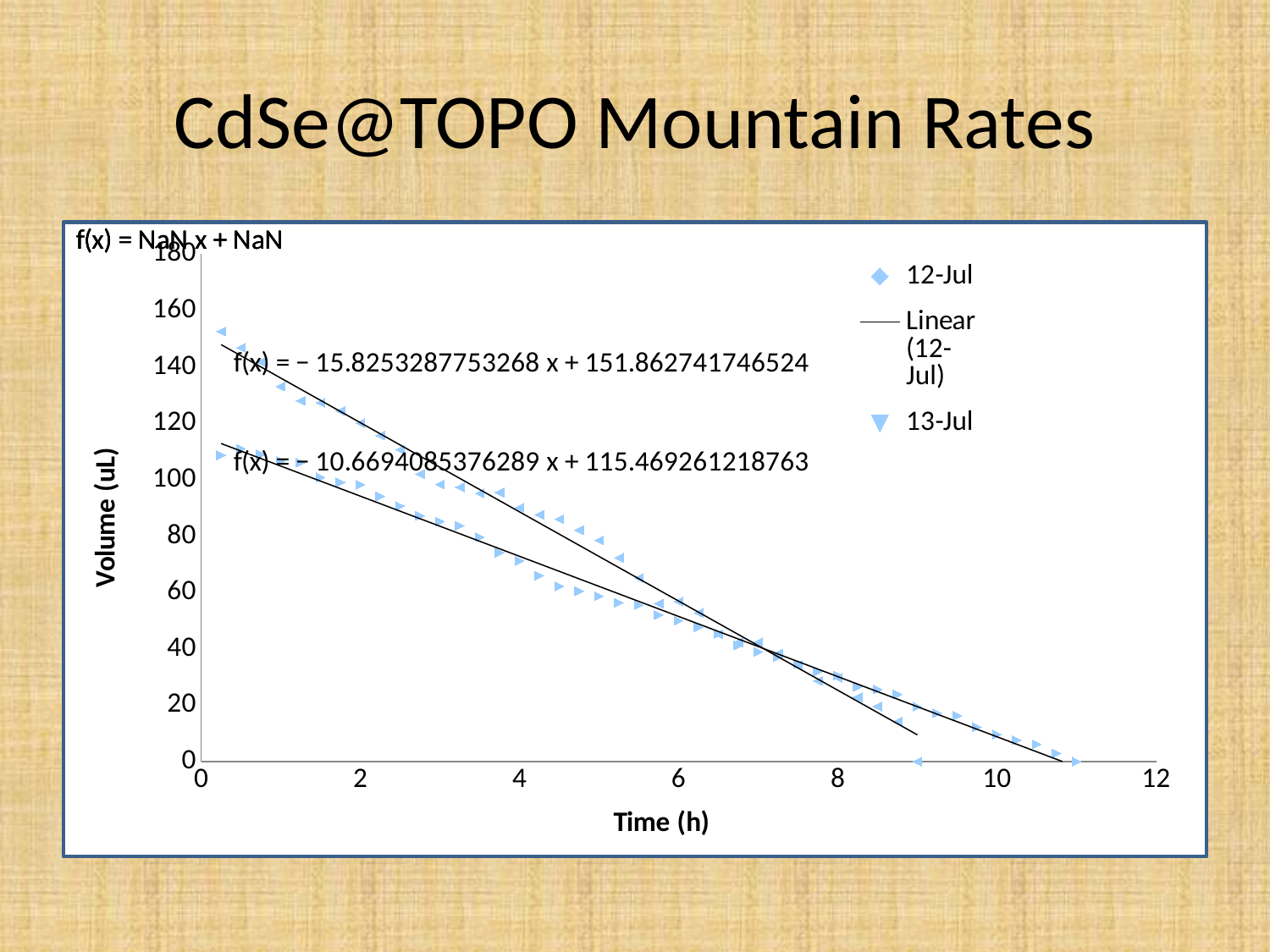
What is the intercept in the trendline equation printed lower on the chart? 115.469261218763 What kind of chart is shown on the slide? scatter chart Do the plotted volume values rise or fall as time increases? fall Which series reaches a volume of 0 at a later time: the one that starts near 150 or the one that starts near 110? the one that starts near 110 Is the starting value (near time 0) of the series that begins lower greater or less than 120? less What is the title of the slide's chart? CdSe@TOPO Mountain Rates What is the slope in the trendline equation printed higher on the chart? − 15.8253287753268 What is the label of the chart's x axis? Time (h) How many entries does the chart's legend list? 3 Is the starting value (near time 0) of the series that begins highest greater or less than 140? greater What is the highest value shown on the chart's x axis? 12 What is the highest value shown on the chart's y axis? 180